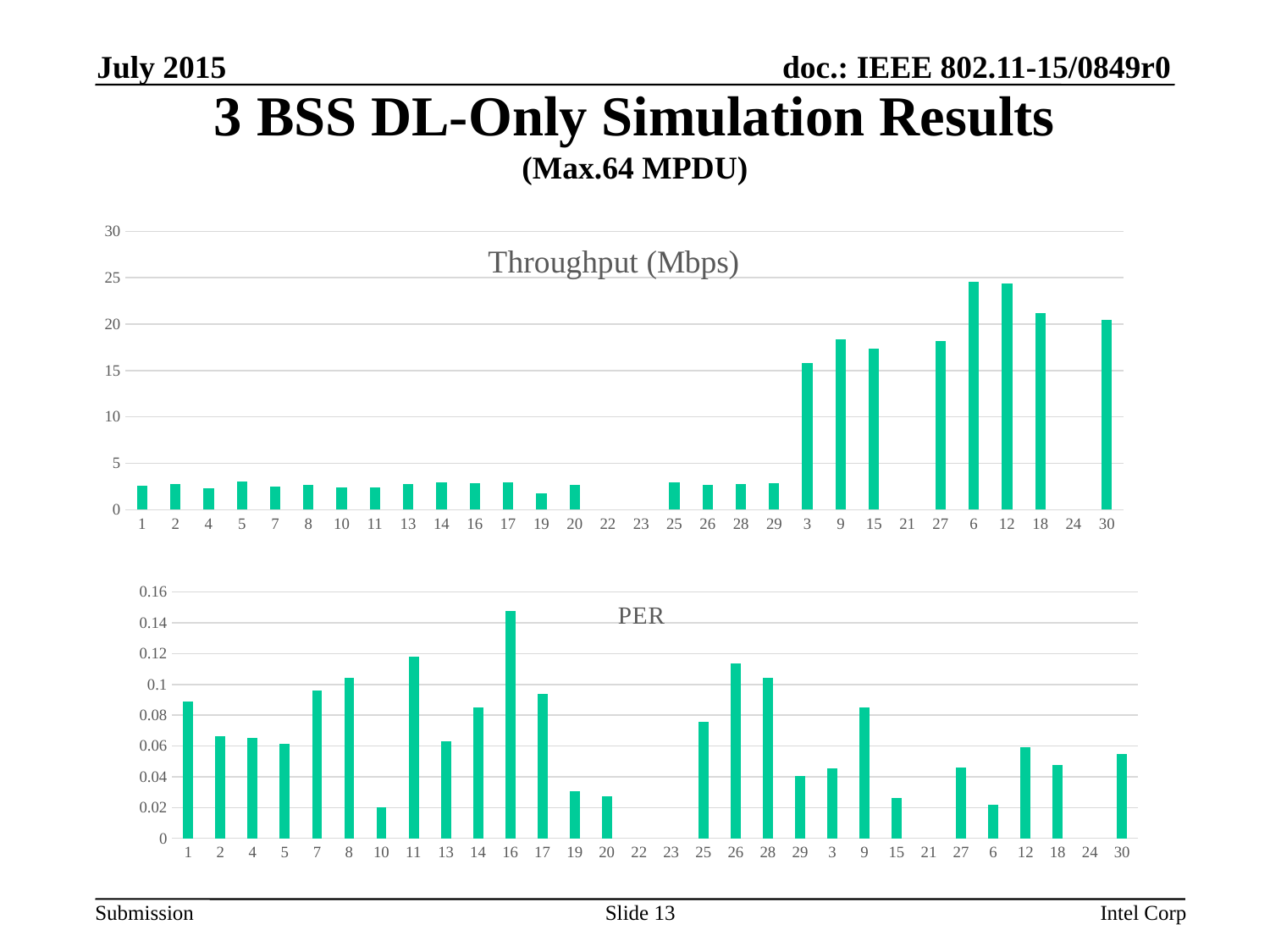
In the Throughput (Mbps) chart, is the value for category 6 greater or less than 20? greater In the Throughput (Mbps) chart, which is larger, the value for category 3 or the value for category 27? 27 What is the title of the lower chart on the slide? PER What kind of chart is the Throughput (Mbps) chart? bar chart In the Throughput (Mbps) chart, which is larger, the value for category 6 or the value for category 30? 6 In the Throughput (Mbps) chart, is the value for category 3 greater or less than 10? greater In the PER chart, is the value for category 10 greater or less than 0.04? less In the PER chart, which category has the highest value? 16 In the PER chart, which is larger, the value for category 1 or the value for category 2? 1 How many categories are shown on the x axis of the PER chart? 30